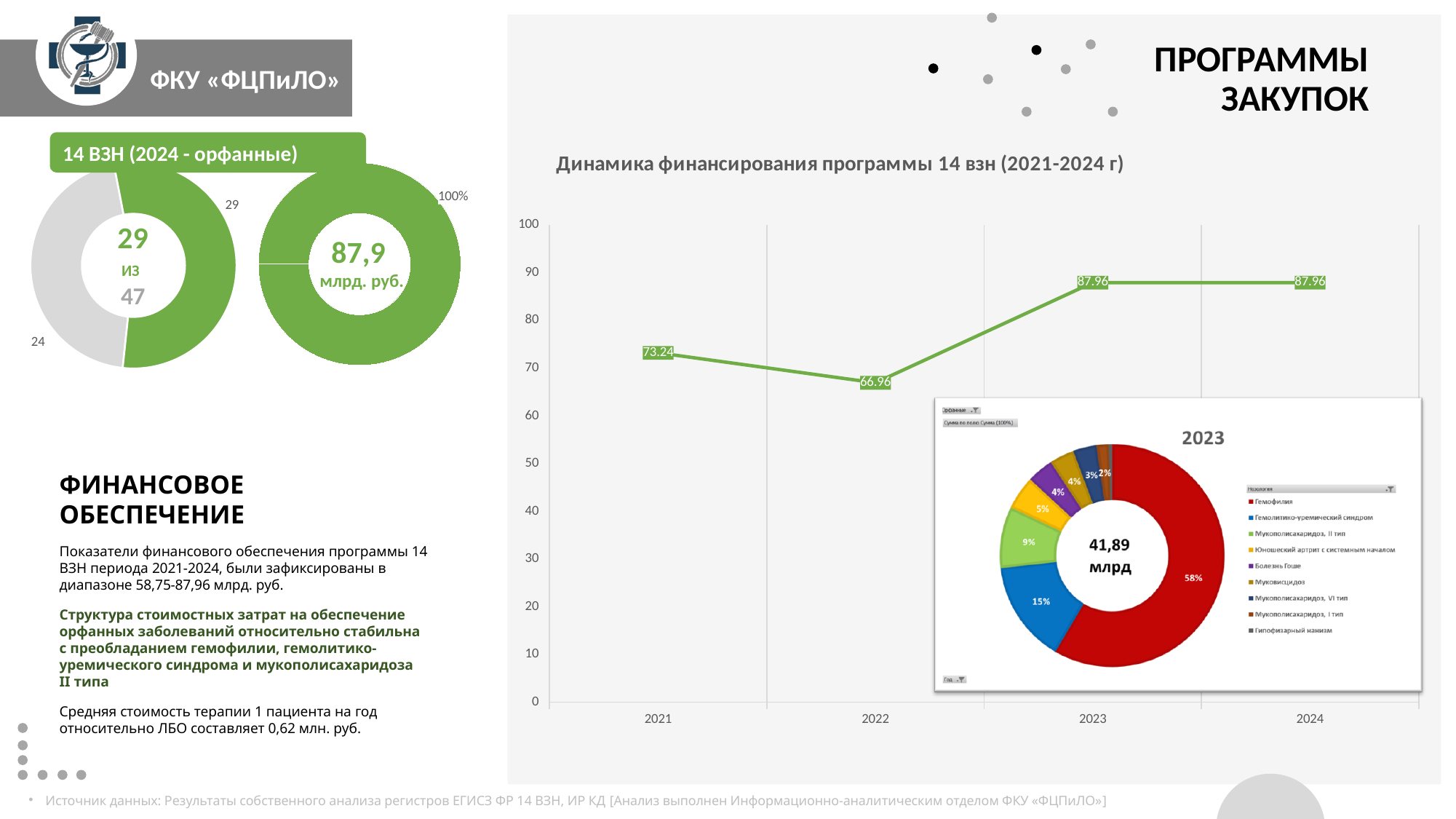
In the line chart 'Динамика финансирования программы 14 взн (2021-2024 г)', what is the value for 2022? 66.96 In the 2023 donut chart inset, what share does Гемофилия have? 58% What kind of chart is 'Динамика финансирования программы 14 взн (2021-2024 г)'? line chart In the line chart 'Динамика финансирования программы 14 взн (2021-2024 г)', which year has the lowest value? 2022 In the 2023 donut chart inset, what share does Гемолитико-уремический синдром have? 15% In the line chart 'Динамика финансирования программы 14 взн (2021-2024 г)', which is larger, the value for 2021 or the value for 2022? 2021 In the line chart 'Динамика финансирования программы 14 взн (2021-2024 г)', does the value rise or fall from 2022 to 2023? rise In the line chart 'Динамика финансирования программы 14 взн (2021-2024 г)', what is the difference between the 2023 value and the 2022 value? 21.00 In the line chart 'Динамика финансирования программы 14 взн (2021-2024 г)', what is the value for 2023? 87.96 In the left donut chart under '14 ВЗН (2024 - орфанные)', what number is shown in the centre as the total (out of)? 47 In the line chart 'Динамика финансирования программы 14 взн (2021-2024 г)', what is the value for 2021? 73.24 In the line chart 'Динамика финансирования программы 14 взн (2021-2024 г)', how many years are plotted on the x axis? 4